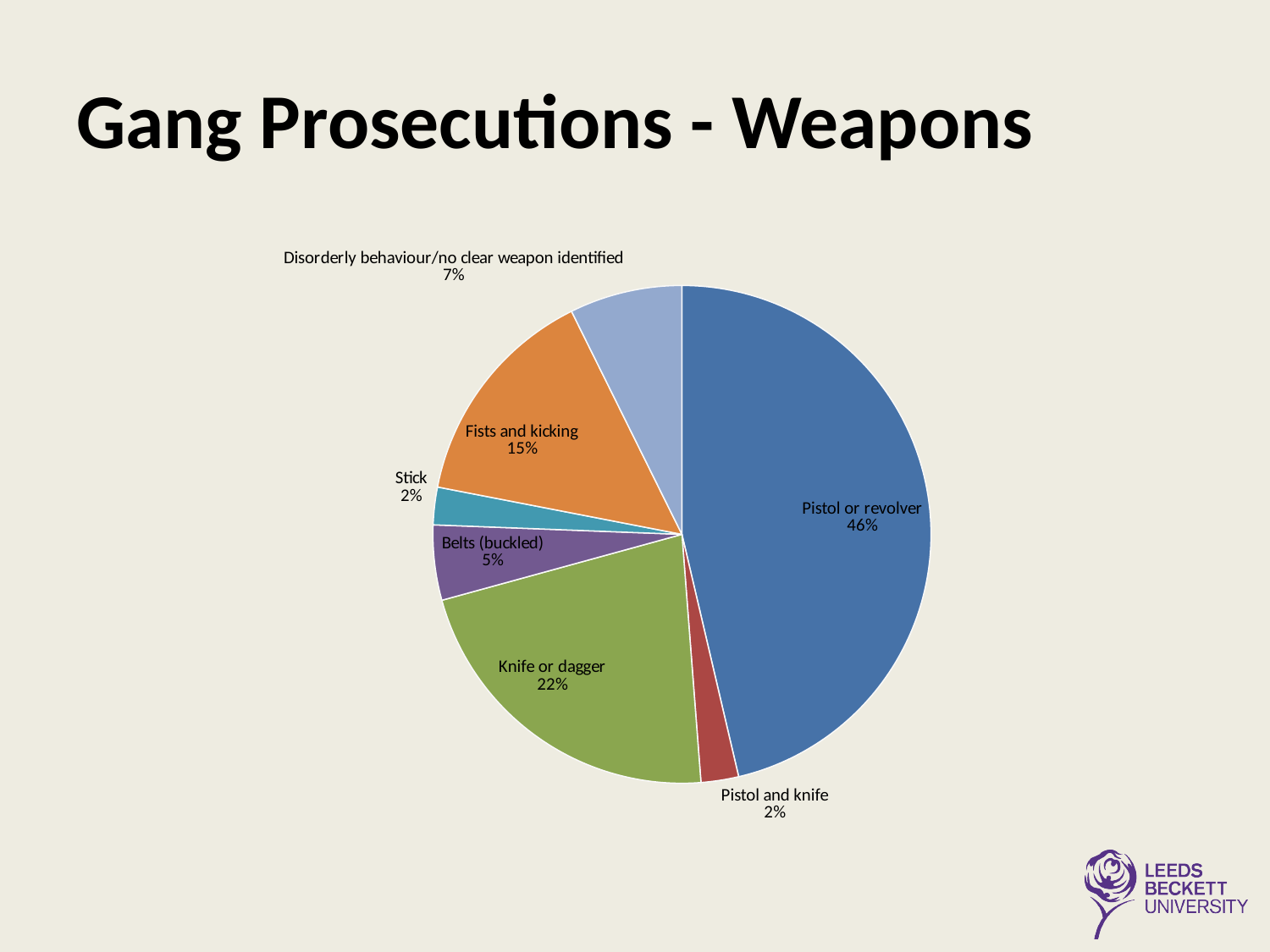
Which is larger, Fists and kicking or Belts (buckled)? Fists and kicking What kind of chart is shown on the slide? pie chart What percentage is shown for Belts (buckled)? 5% What is the difference in percentage points between Pistol or revolver and Knife or dagger? 24 How many slices does the pie chart have? 7 What is the title of the slide containing the chart? Gang Prosecutions - Weapons What percentage is shown for Disorderly behaviour/no clear weapon identified? 7% Which category has the largest slice of the pie? Pistol or revolver What percentage is shown for Knife or dagger? 22% What share of the pie is Pistol or revolver? 46% What percentage is shown for Fists and kicking? 15% What percentage is shown for Stick? 2%